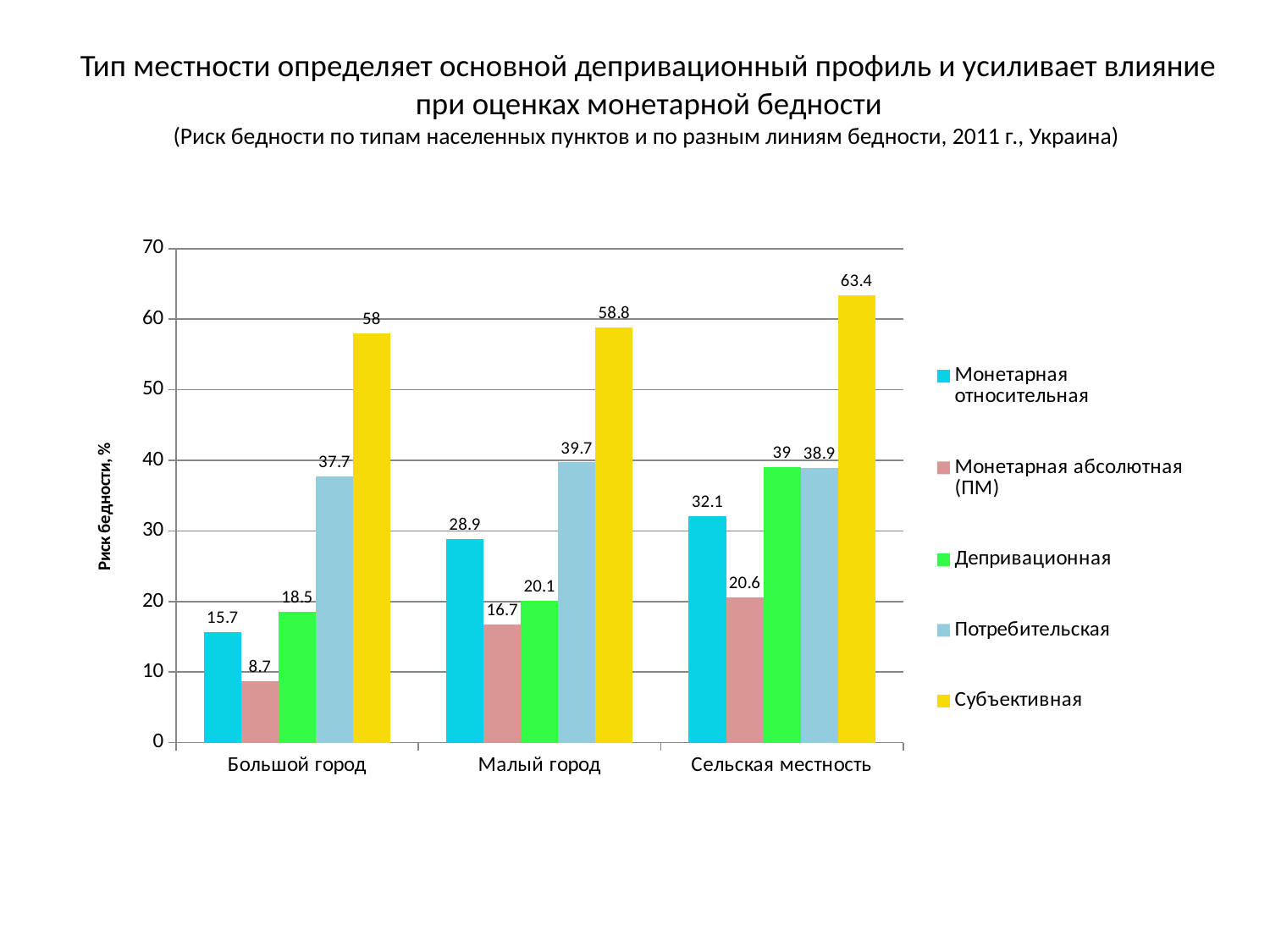
What is the value for Субъективная in Сельская местность? 63.4 Which series has the lowest value in Сельская местность? Монетарная абсолютная (ПМ) What is the value for Потребительская in Малый город? 39.7 Is the value for Монетарная относительная in Малый город greater or less than 30? less What is the difference between the Субъективная values for Сельская местность and Большой город? 5.4 What kind of chart is shown on the slide? bar chart How many categories of settlement type are shown on the x axis? 3 Which series has the highest value in Малый город? Субъективная How many series does the legend list? 5 Which is larger: Депривационная in Сельская местность or Депривационная in Малый город? Сельская местность Does the value for Монетарная относительная rise or fall from Большой город to Сельская местность? rise What is the value for Монетарная абсолютная (ПМ) in Большой город? 8.7